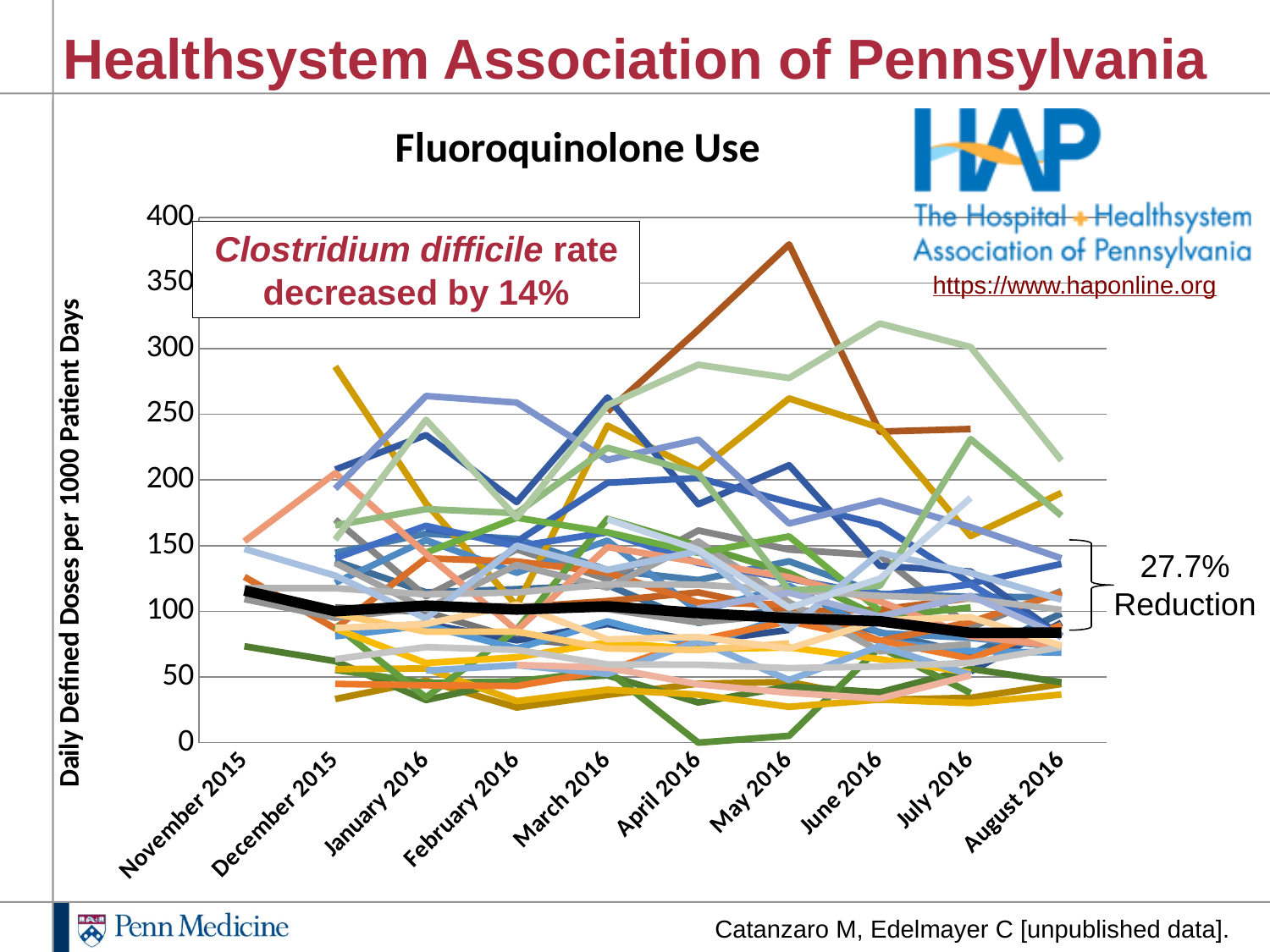
Is the highest point reached by any line in May 2016 greater or less than 350? greater Is the value of the thick black line in November 2015 greater or less than 100? greater Does the thick black line rise or fall from November 2015 to August 2016? fall How many months are shown along the x axis of the chart? 10 What kind of chart is shown on the slide? line chart What is the title of the chart? Fluoroquinolone Use Which month is the first category on the x axis? November 2015 What percentage reduction is annotated next to the thick black line? 27.7% Is the value of the thick black line in August 2016 greater or less than 100? less What is the label of the vertical axis of the chart? Daily Defined Doses per 1000 Patient Days In which month does any line reach its highest point on the chart? May 2016 Which month is the last category on the x axis? August 2016